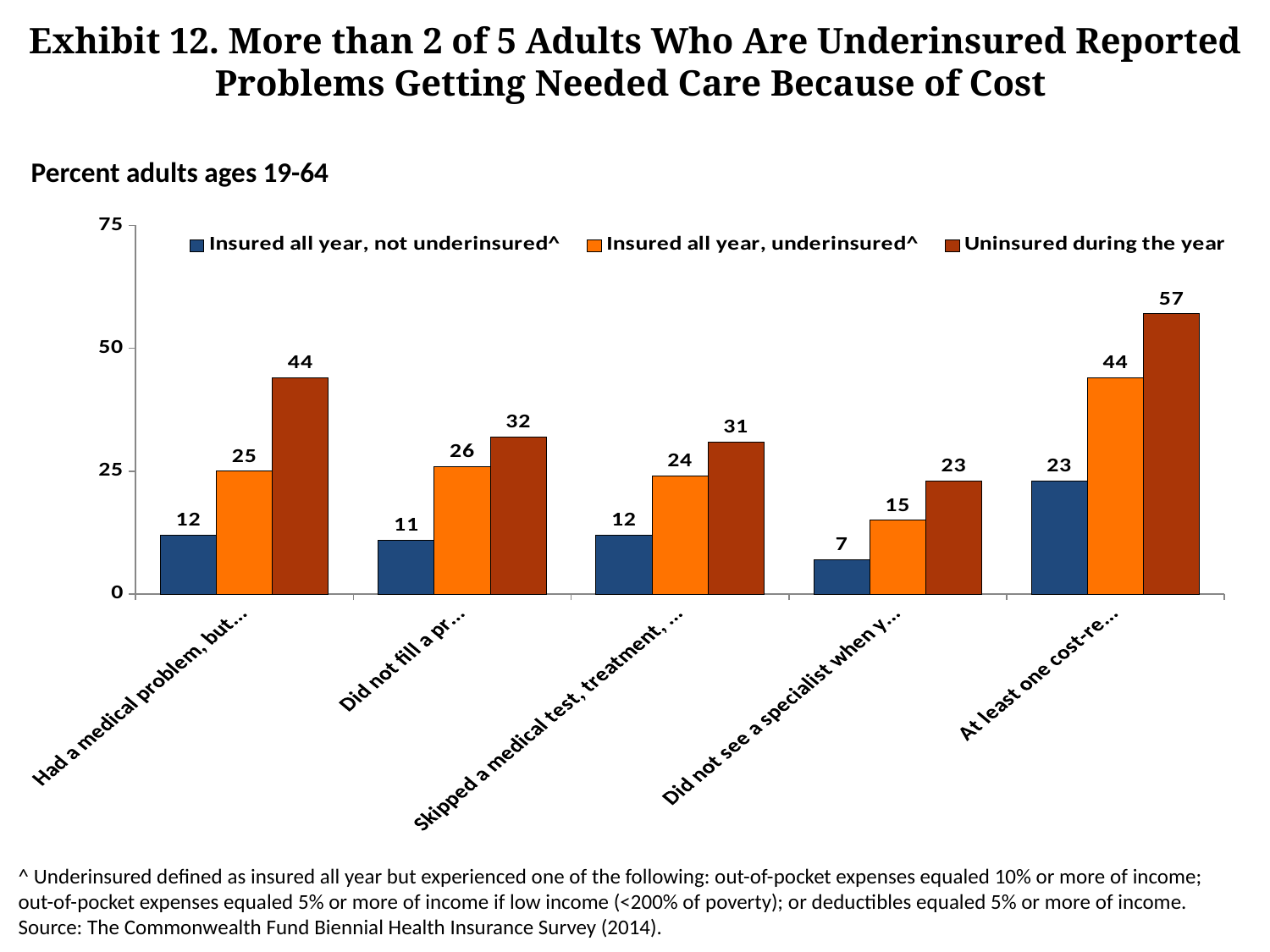
In the "Skipped a medical test, treatment, ..." category, which is larger: "Insured all year, underinsured^" or "Uninsured during the year"? Uninsured during the year What is the difference between the "Uninsured during the year" and "Insured all year, not underinsured^" values in the "Had a medical problem, but..." category? 32 How many series does the legend list? 3 What is the value for "Insured all year, not underinsured^" in the "At least one cost-re..." category? 23 How many categories are shown along the x axis? 5 What colour are the bars for the "Insured all year, underinsured^" series? orange Which category has the lowest value for "Insured all year, not underinsured^"? Did not see a specialist when y... Is the value for "Uninsured during the year" in the "At least one cost-re..." category greater or less than 50? greater What is the value for "Uninsured during the year" in the "Did not fill a pr..." category? 32 What kind of chart is shown on the slide? bar chart Which category has the highest value for "Uninsured during the year"? At least one cost-re... What is the value for "Insured all year, underinsured^" in the "Did not see a specialist when y..." category? 15